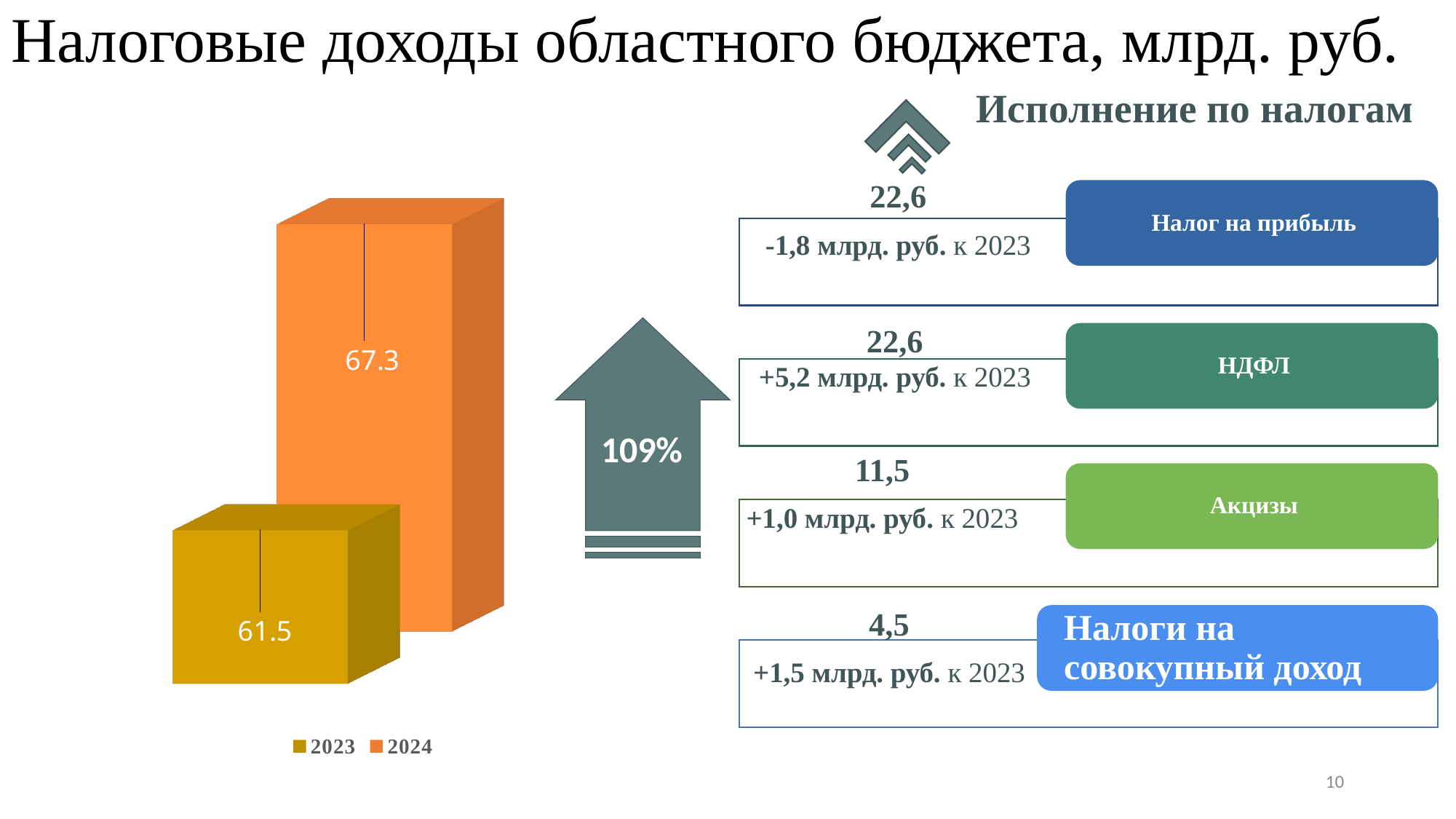
Do the values rise or fall from 2023 to 2024 in the chart? rise How many bars are plotted in the chart? 2 What is the difference between the 2024 and 2023 values in the bar chart? 5.8 What is the value of the 2023 bar in the bar chart? 61.5 Is the value for 2024 larger or smaller than the value for 2023? larger What is the value of the 2024 bar in the bar chart? 67.3 What type of chart is shown on the left of the slide? bar chart How many entries does the chart legend list? 2 Which year has the higher bar in the chart? 2024 What colour is the 2024 bar in the chart? orange What is the title of the slide containing the bar chart? Налоговые доходы областного бюджета, млрд. руб. Which year has the lower bar in the chart? 2023